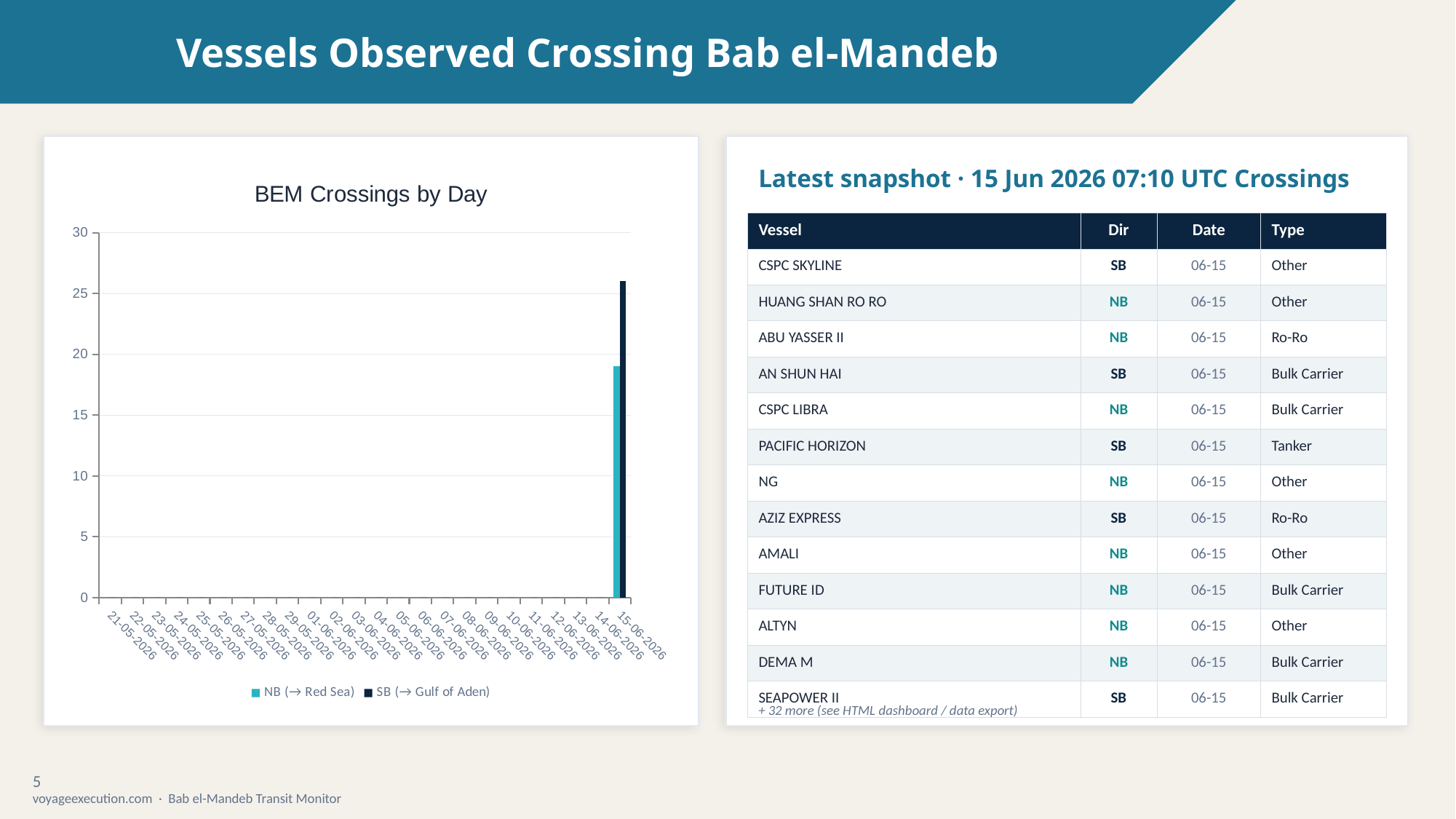
What is the title of the chart on the left of the slide? BEM Crossings by Day What is the highest value shown on the y axis of 'BEM Crossings by Day'? 30 What are the two series named in the legend of 'BEM Crossings by Day'? NB (→ Red Sea) and SB (→ Gulf of Aden) In 'BEM Crossings by Day', is the NB (→ Red Sea) value for 15-06-2026 greater or less than 15? greater How many series does the legend of 'BEM Crossings by Day' list? 2 In 'BEM Crossings by Day', is the SB (→ Gulf of Aden) value for 15-06-2026 greater or less than 25? greater How many dates are shown on the x axis of 'BEM Crossings by Day'? 24 In 'BEM Crossings by Day', which date has the highest number of crossings? 15-06-2026 In 'BEM Crossings by Day', is the NB (→ Red Sea) value for 15-06-2026 greater or less than 20? less What kind of chart is 'BEM Crossings by Day'? bar chart In 'BEM Crossings by Day', on 15-06-2026, which series is larger, NB (→ Red Sea) or SB (→ Gulf of Aden)? SB (→ Gulf of Aden)